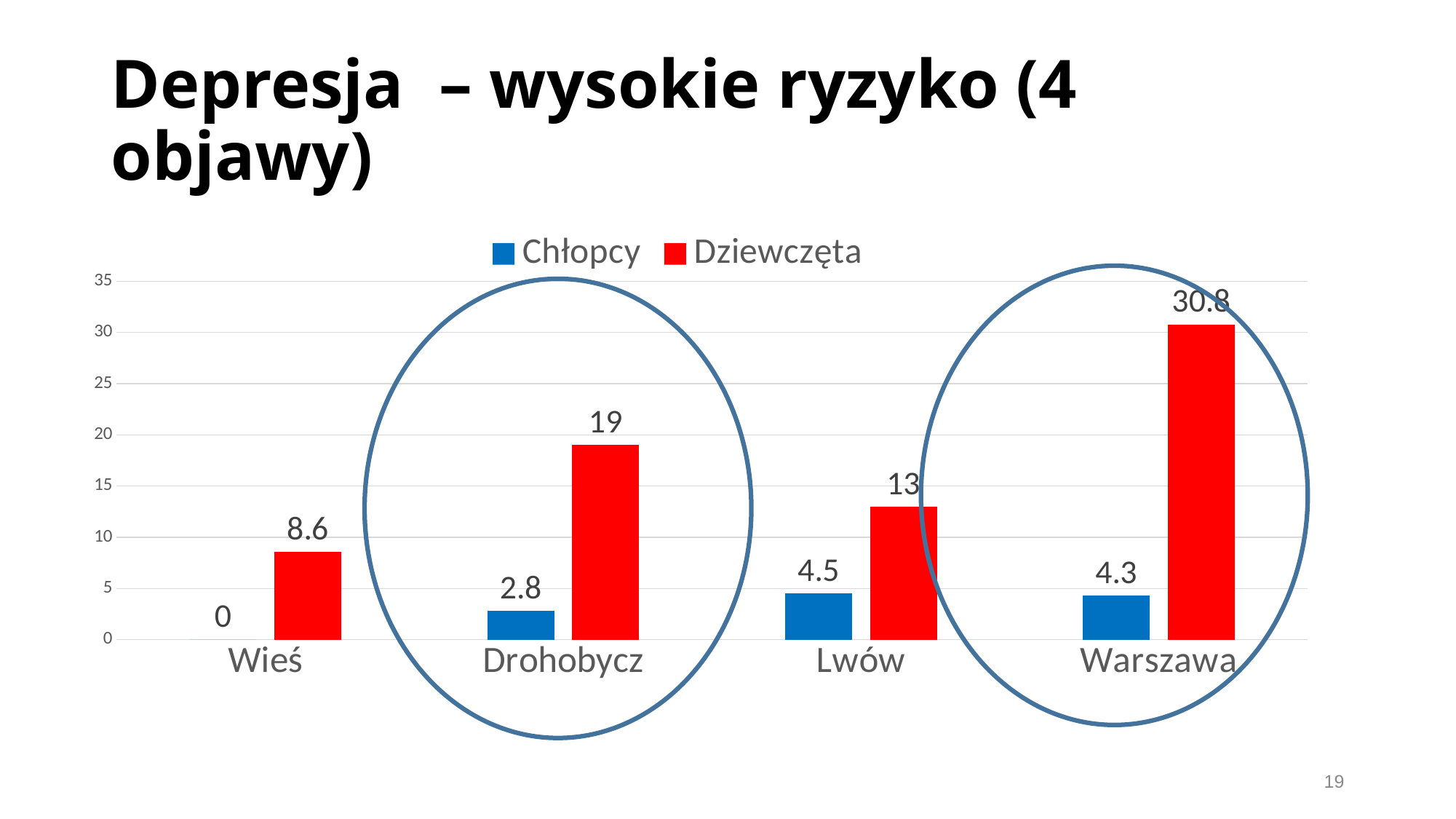
What is the value for Dziewczęta in Warszawa? 30.8 What is the value for Dziewczęta in Wieś? 8.6 What is the value for Chłopcy in Drohobycz? 2.8 What is the difference between the Dziewczęta and Chłopcy values in Warszawa? 26.5 How many categories are shown on the x axis? 4 Which category has the lowest value for Chłopcy? Wieś Which is larger: the Dziewczęta value in Drohobycz or in Lwów? Drohobycz Which colour represents the Dziewczęta series? Red How many series does the legend list? 2 What kind of chart is shown on the slide? Bar chart What is the value for Chłopcy in Lwów? 4.5 Which category has the highest value for Dziewczęta? Warszawa